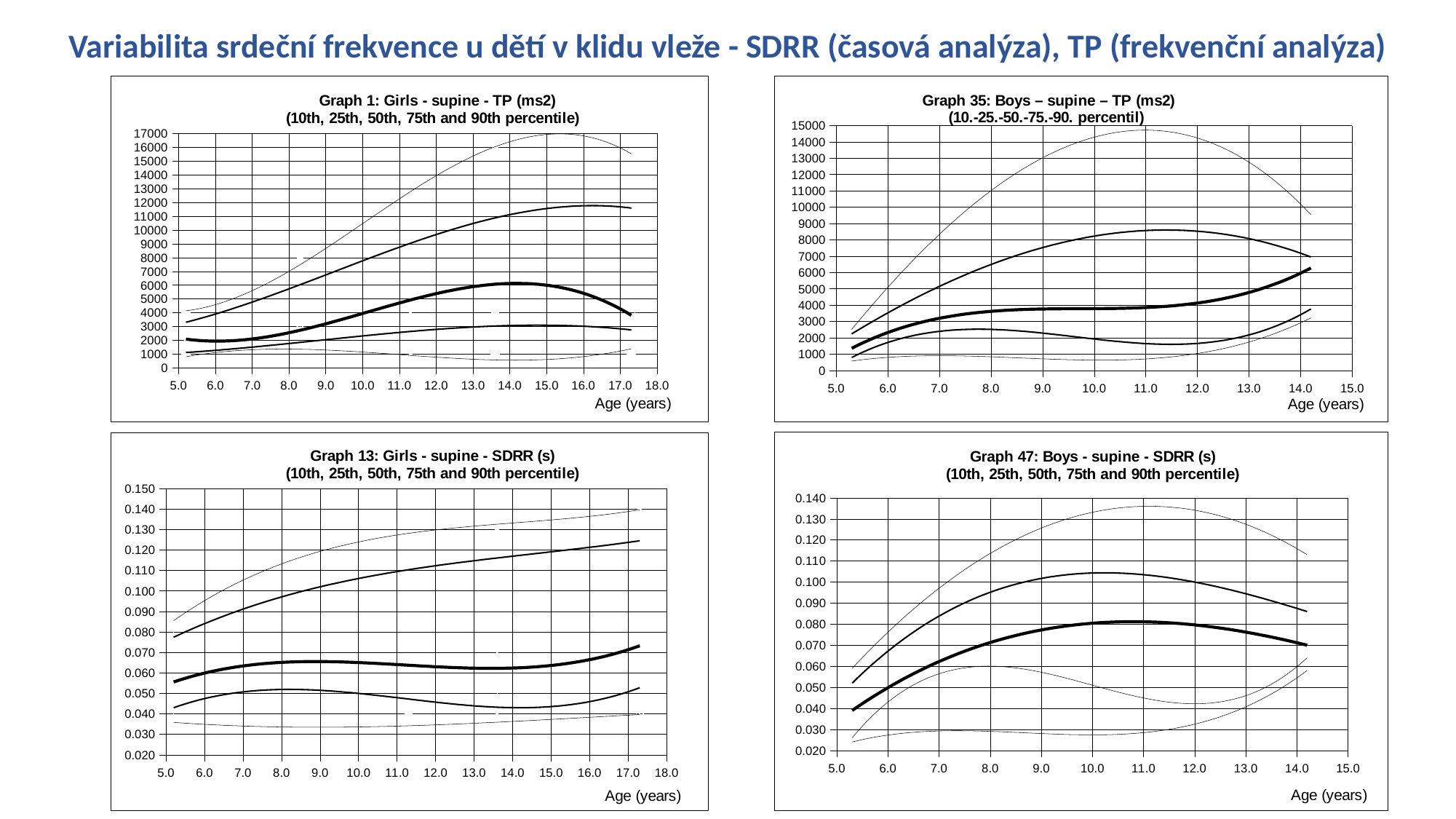
What kind of chart is Graph 1: Girls - supine - TP (ms2)? line chart What is the x-axis label on Graph 35: Boys – supine – TP (ms2)? Age (years) How many percentile curves are plotted in Graph 13: Girls - supine - SDRR (s)? 5 In Graph 1: Girls - supine - TP (ms2), is the peak value reached by the topmost (90th percentile) curve greater or less than 15000? greater In Graph 1: Girls - supine - TP (ms2), is the value of the thick 50th percentile curve at age 14.0 greater or less than 5000? greater In Graph 35: Boys – supine – TP (ms2), is the value of the topmost curve at age 14.0 greater or less than 12000? less In Graph 13: Girls - supine - SDRR (s), does the topmost curve rise or fall from age 5.0 to age 17.0? rise How many charts are shown on the slide? 4 Which chart's topmost curve reaches a higher peak value, Graph 1 (Girls TP) or Graph 35 (Boys TP)? Graph 1 What is the title of the bottom-left chart? Graph 13: Girls - supine - SDRR (s)